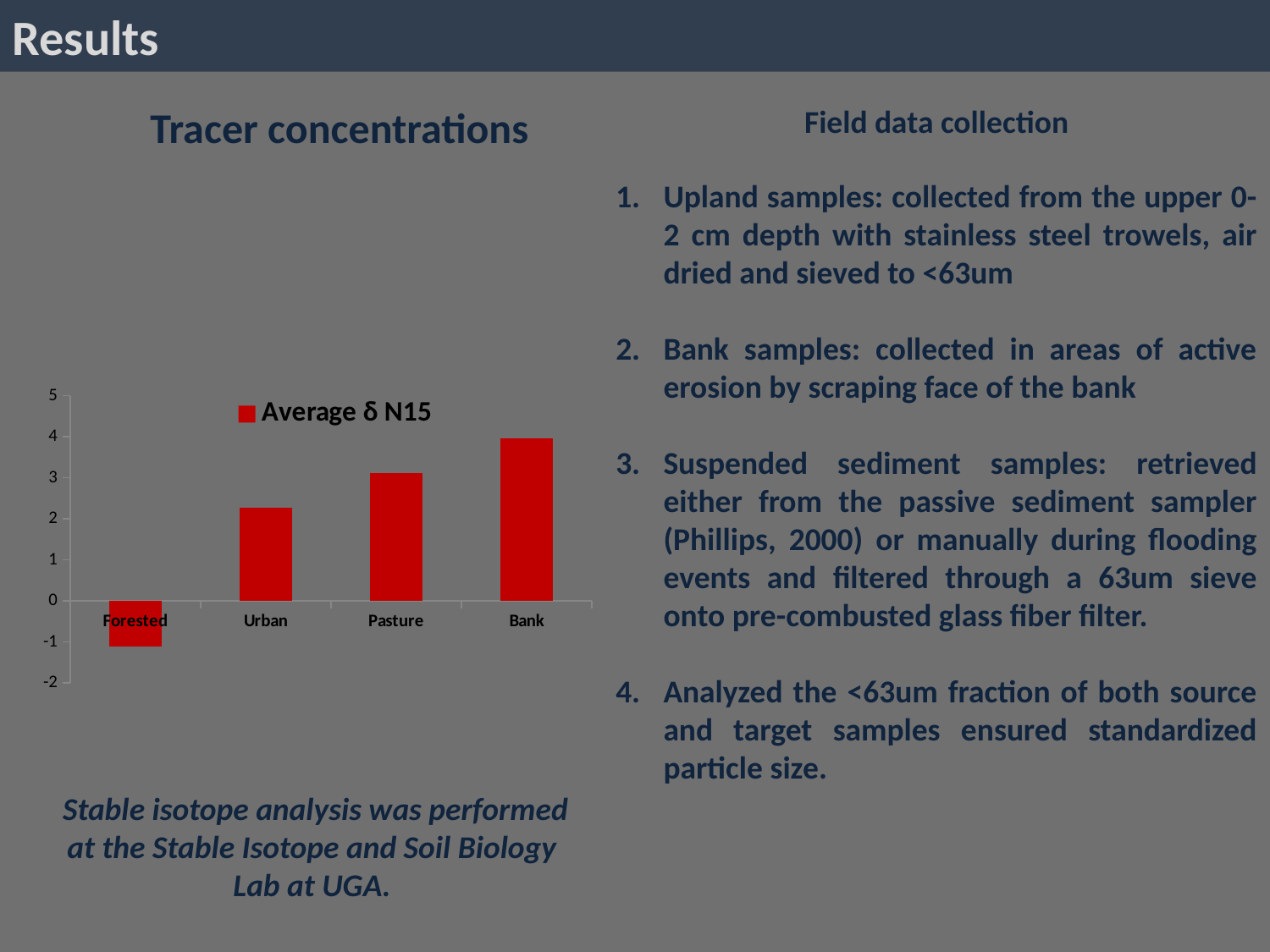
Which category has the lowest Average δ N15 value? Forested Which category has the highest Average δ N15 value? Bank How many series does the legend of the bar chart list? 1 Is the Average δ N15 value for Urban greater or less than 2? greater Is the Average δ N15 value for Forested greater or less than 0? less How many categories are shown on the x axis of the bar chart? 4 Which has a larger Average δ N15 value, Forested or Urban? Urban What series name is shown in the legend of the bar chart? Average δ N15 What kind of chart is shown under the title "Tracer concentrations"? bar chart Do the Average δ N15 values rise or fall from Forested to Bank along the x axis? rise Which has a larger Average δ N15 value, Urban or Pasture? Pasture Is the Average δ N15 value for Bank greater or less than 3? greater